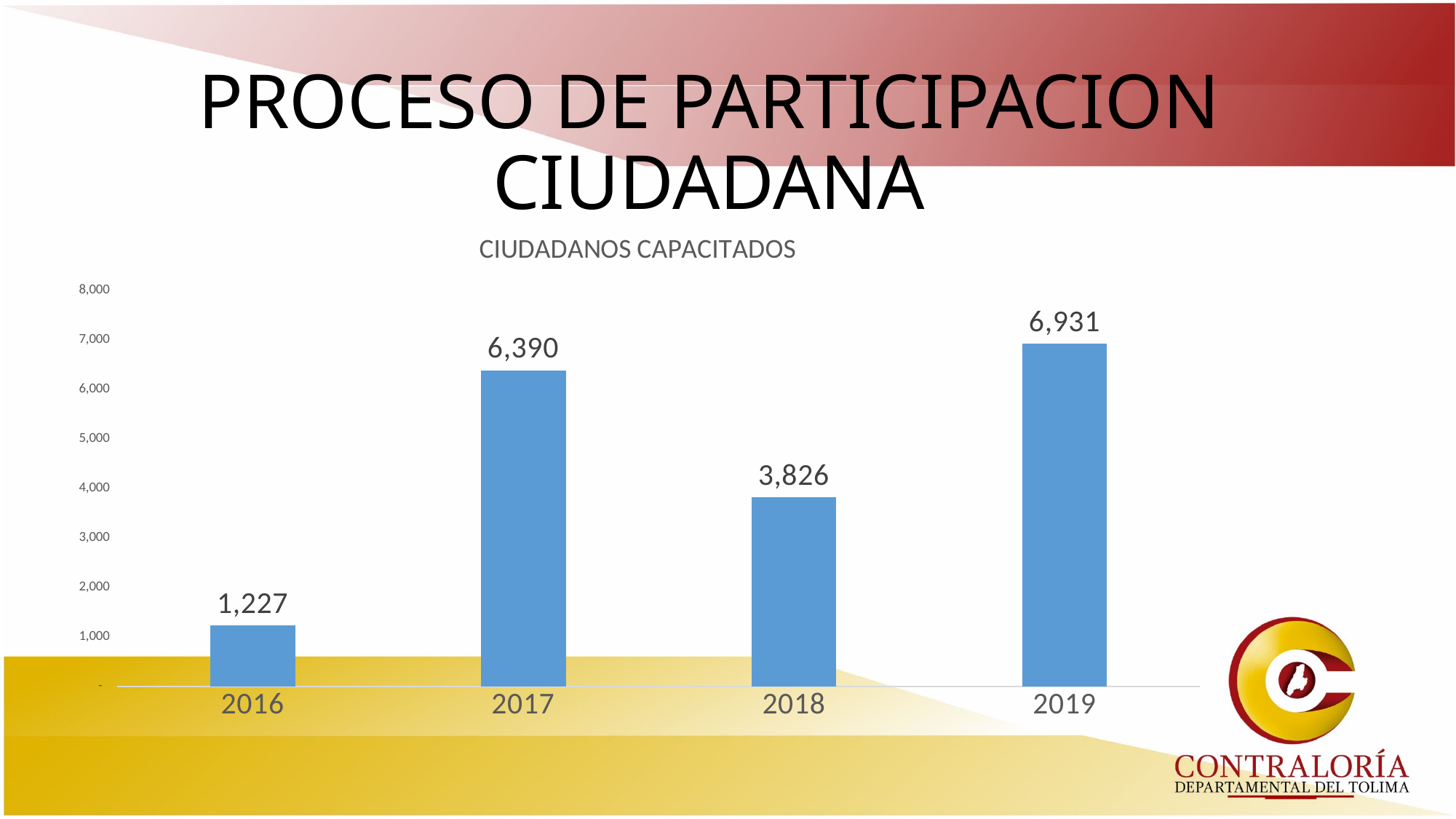
What is the value for 2019? 6,931 Is the value for 2018 greater or less than 4,000? less How many years are shown on the x axis? 4 Which year has the highest value? 2019 What is the difference between the values for 2019 and 2017? 541 What is the value for 2018? 3,826 Which is larger, the value for 2018 or the value for 2017? 2017 What is the value for 2017? 6,390 Which year has the lowest value? 2016 What kind of chart is shown? bar chart What is the difference between the values for 2017 and 2016? 5,163 What is the value for 2016? 1,227